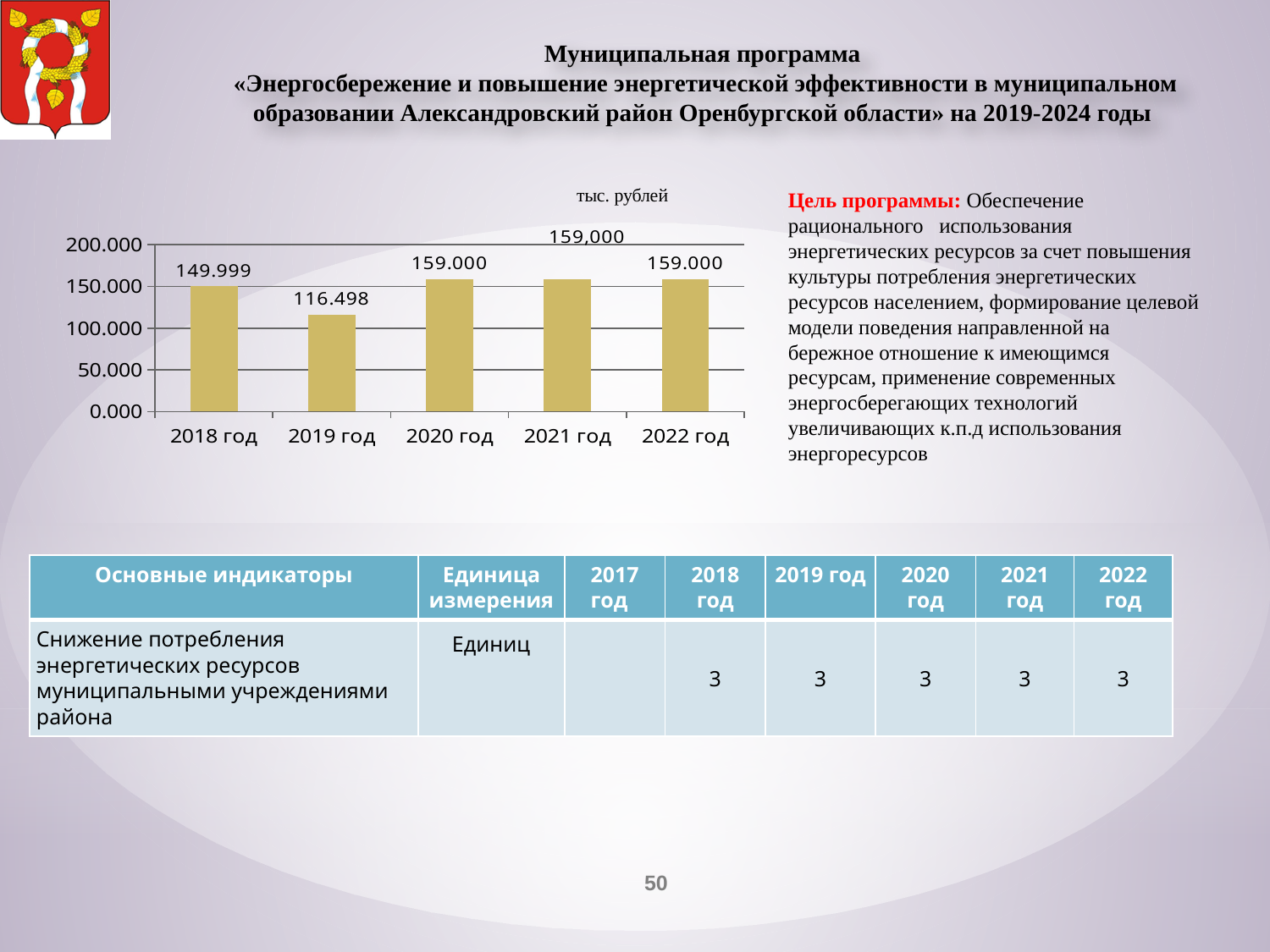
What is the difference between the values for 2020 год and 2019 год? 42.502 Which year has the lowest value? 2019 год What is the value for 2018 год? 149.999 How many years are shown on the chart? 5 Is the value for 2019 год greater or less than 150.000? less What is the value for 2019 год? 116.498 What is the difference between the values for 2018 год and 2019 год? 33.501 What kind of chart is shown on the slide? bar chart What is the value for 2022 год? 159.000 Which is larger, the value for 2018 год or the value for 2020 год? 2020 год What unit is indicated above the chart? тыс. рублей What is the value for 2020 год? 159.000